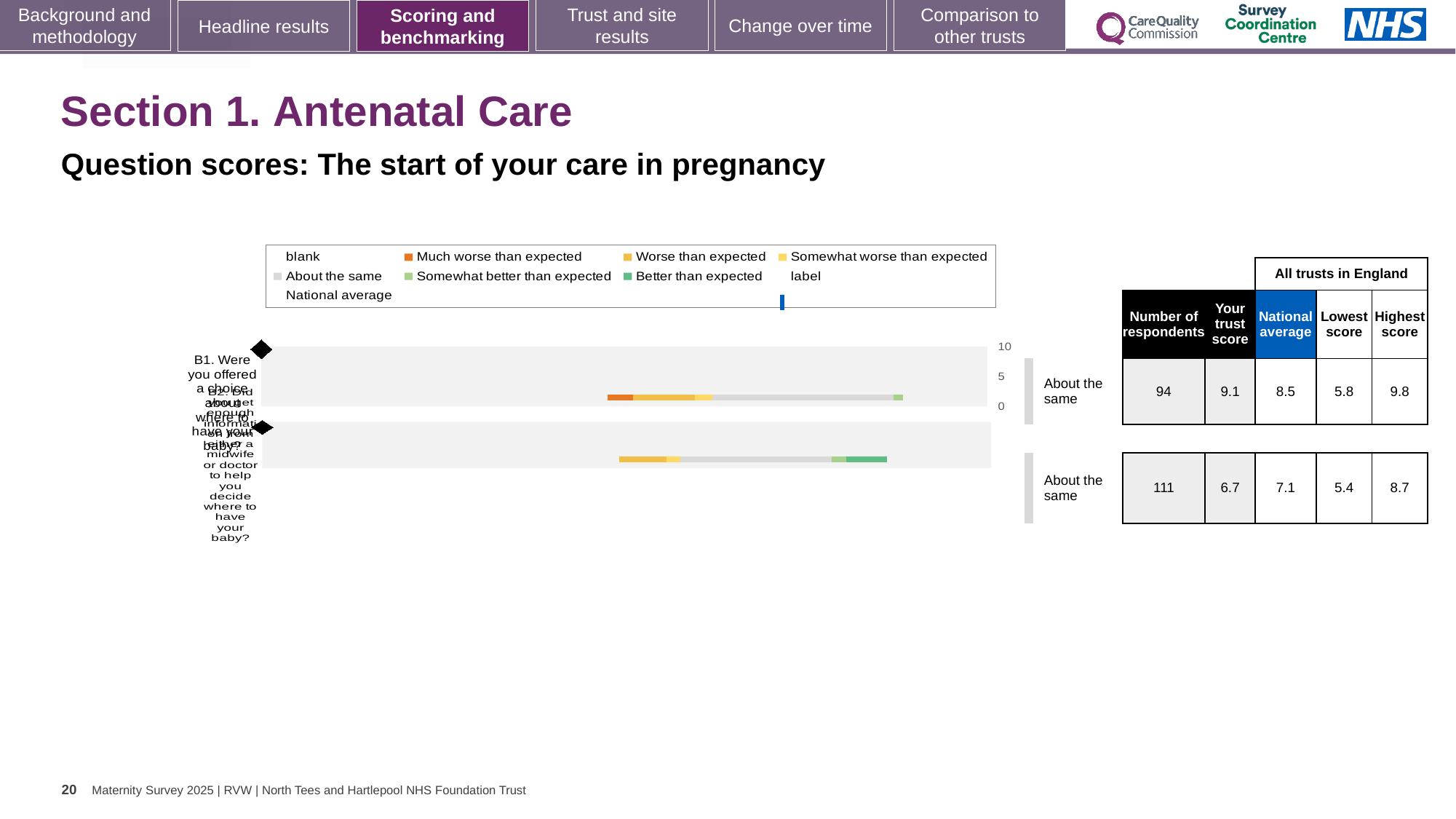
How many respondents answered question B2? 111 For question B1, which is higher: the trust score or the National average? the trust score What colour does the legend use for 'Much worse than expected'? orange For question B2, which is higher: the trust score or the National average? the National average What is the difference between the Highest score and the Lowest score for question B1? 4.0 What is the Lowest score across all trusts in England for question B2? 5.4 Which question has the higher trust score, B1 or B2? B1 What is the National average for question B1? 8.5 What kind of chart is shown on the slide? bar chart How many survey questions (bars) are plotted in the chart? 2 What is the difference between the National average and the trust score for question B2? 0.4 What is the 'Your trust score' for question B1 (Were you offered a choice about where to have your baby?)? 9.1